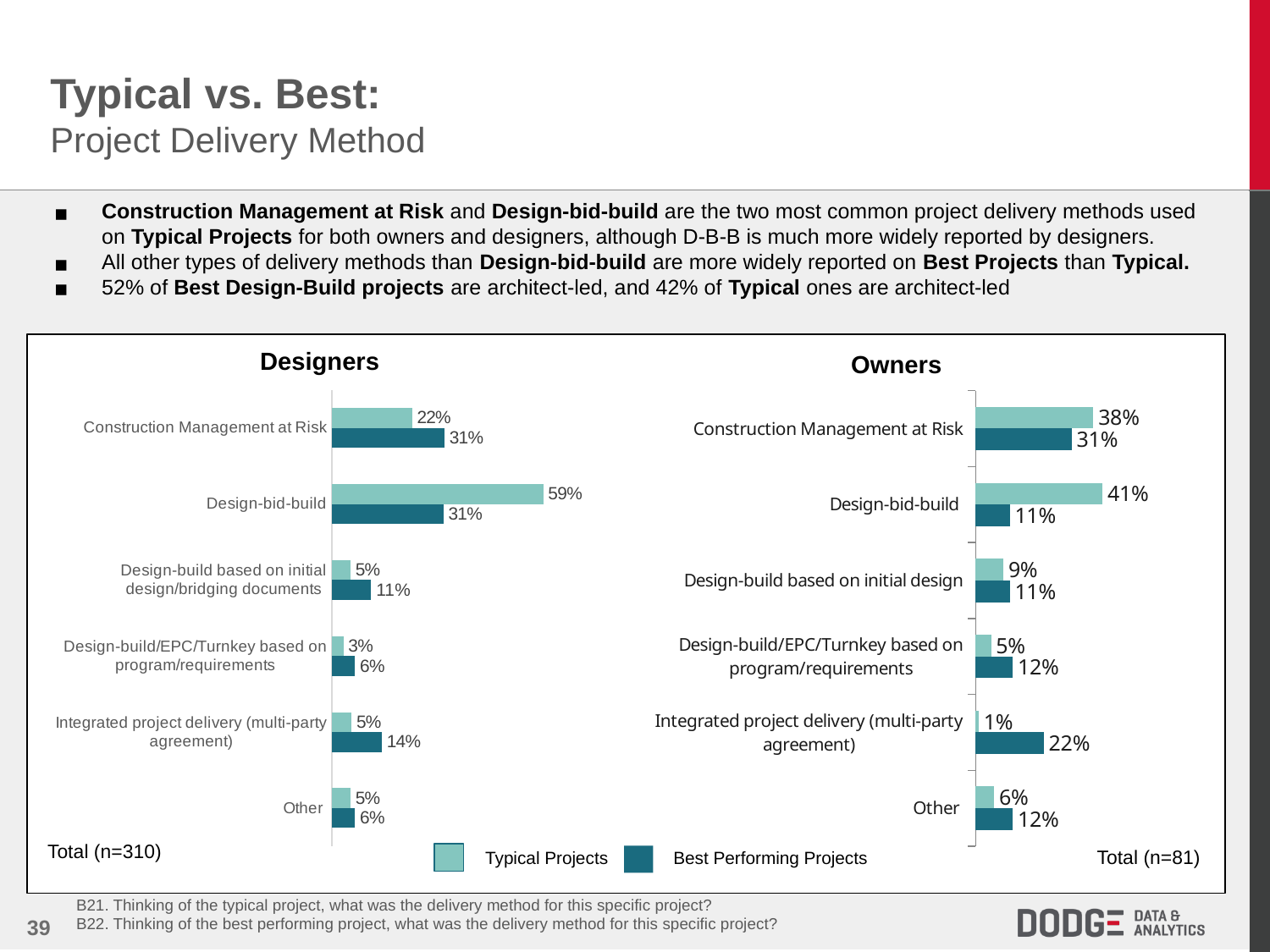
In the Owners chart, which category has the lowest value for Typical Projects? Integrated project delivery (multi-party agreement) In the Owners chart, what is the difference between the Typical Projects and Best Performing Projects values for Design-bid-build? 30% In the Designers chart, what is the difference between the Typical Projects and Best Performing Projects values for Design-bid-build? 28% How many series does the legend list? 2 In the Designers chart, which category has the highest value for Typical Projects? Design-bid-build In the Owners chart, which is larger for Design-build/EPC/Turnkey based on program/requirements: Typical Projects or Best Performing Projects? Best Performing Projects In the Owners chart, what is the value for Construction Management at Risk for Typical Projects? 38% What kind of chart is the Owners chart? Bar chart What is the sample size (n) shown for the Owners chart? 81 How many categories are shown in the Designers chart? 6 In the Designers chart, what is the value for Design-bid-build for Typical Projects? 59% In the Owners chart, what is the value for Integrated project delivery (multi-party agreement) for Best Performing Projects? 22%